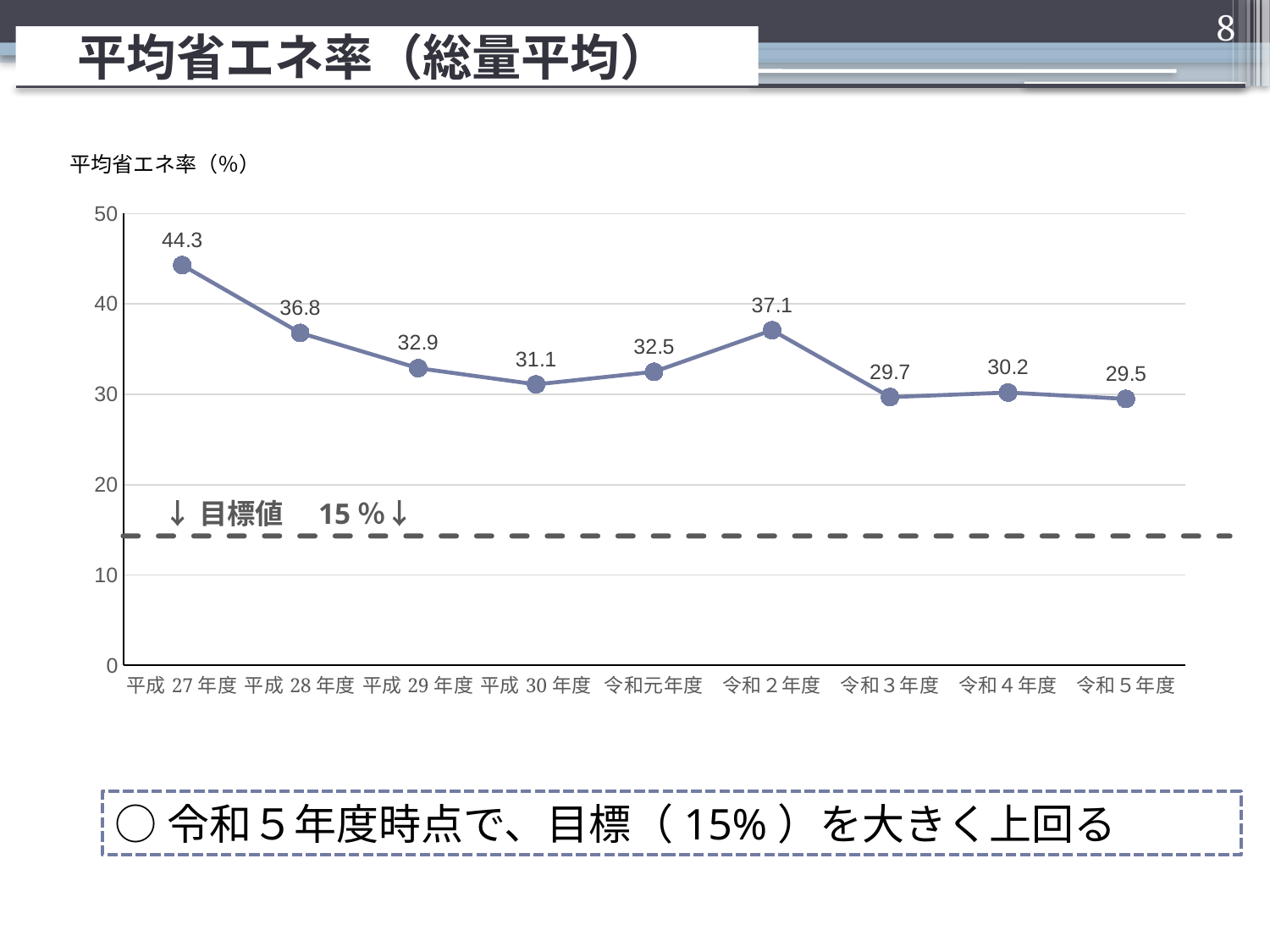
What is the difference between the values for 平成27年度 and 平成28年度? 7.5 What is the value for 令和５年度? 29.5 What kind of chart is shown? line chart Is the value for 平成30年度 greater or less than 40? less How many years are plotted on the chart? 9 What target value (目標値) is marked by the dashed line? 15％ Which year has the highest value? 平成27年度 Do the values generally rise or fall from 平成27年度 to 令和５年度? fall What is the value for 令和２年度? 37.1 Which year has the lowest value? 令和５年度 Which is larger, the value for 令和元年度 or the value for 令和２年度? 令和２年度 What is the value for 平成27年度? 44.3